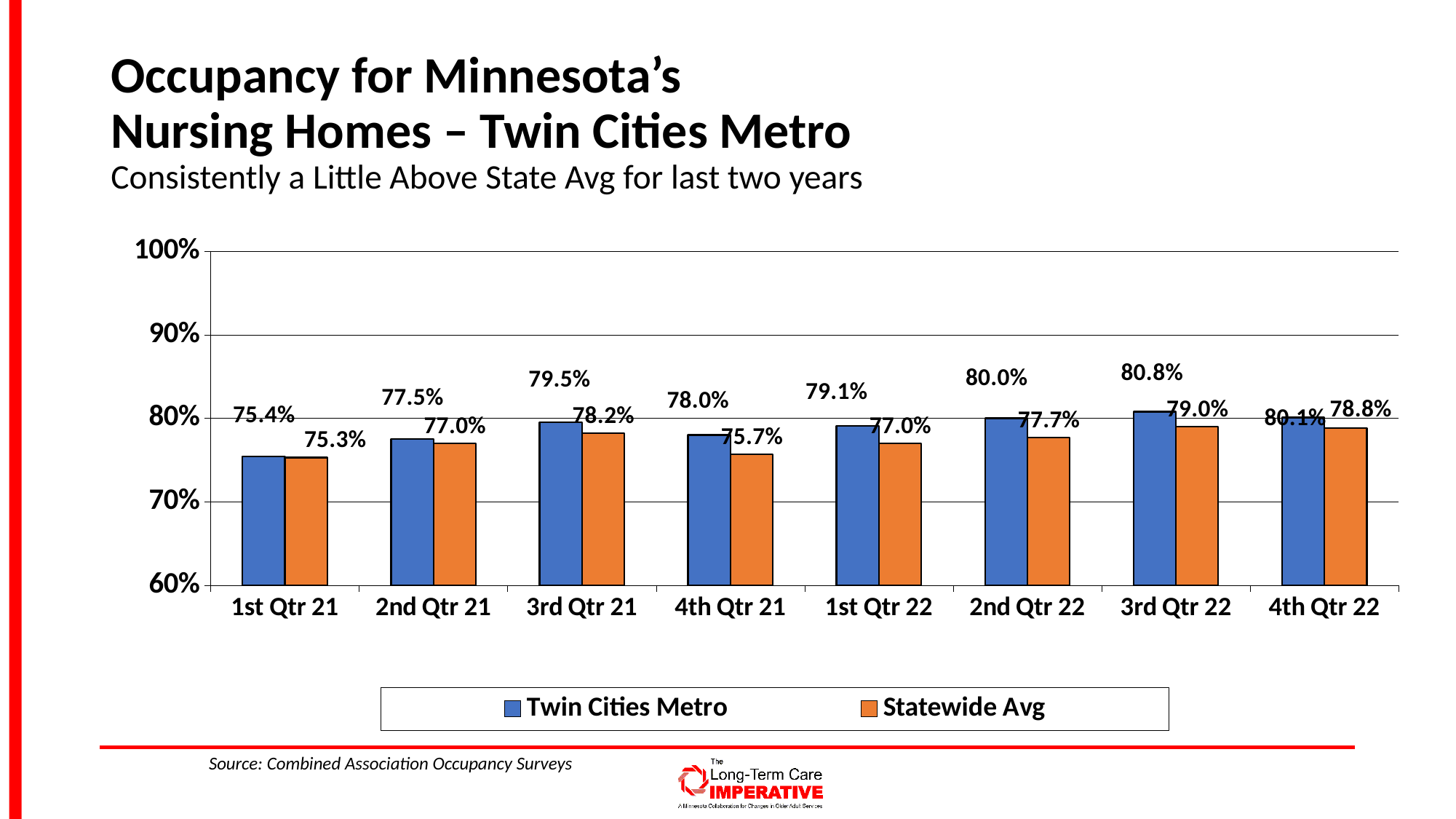
Is the Statewide Avg value for 3rd Qtr 21 greater or less than 80%? less How many quarters are shown on the x axis? 8 Which colour represents Statewide Avg in the chart? orange Which quarter has the lowest Statewide Avg occupancy? 1st Qtr 21 Which quarter has the highest Twin Cities Metro occupancy? 3rd Qtr 22 What is the Twin Cities Metro occupancy value for 3rd Qtr 22? 80.8% What kind of chart is shown on the slide? bar chart How many series does the legend list? 2 What is the Statewide Avg occupancy value for 4th Qtr 21? 75.7% Which is larger in 2nd Qtr 22, Twin Cities Metro or Statewide Avg? Twin Cities Metro What is the difference between the Twin Cities Metro and Statewide Avg values in 4th Qtr 21? 2.3% What is the Twin Cities Metro value for 1st Qtr 21? 75.4%